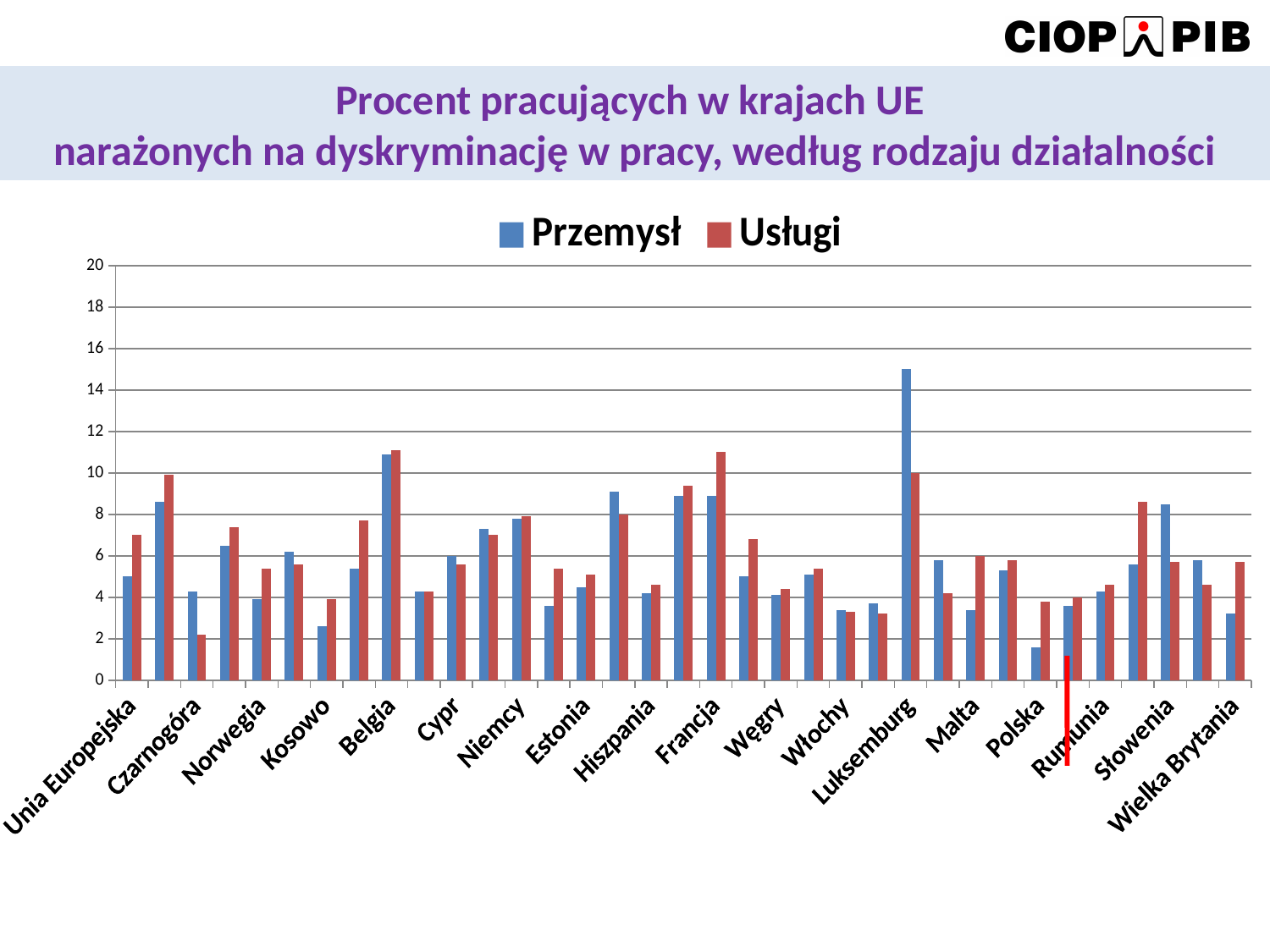
For Słowenia, which is larger: Przemysł or Usługi? Przemysł For Francja, which is larger: Przemysł or Usługi? Usługi For Luksemburg, which is larger: Przemysł or Usługi? Przemysł Is the Przemysł value for Kosowo greater or less than 4? less Which country has the lowest Przemysł value? Polska Which country has the highest Przemysł value? Luksemburg What kind of chart is shown on the slide? bar chart How many series does the legend list? 2 Is the Usługi value for Belgia greater or less than 10? greater What are the two series named in the legend? Przemysł and Usługi Is the Przemysł value for Polska greater or less than 2? less